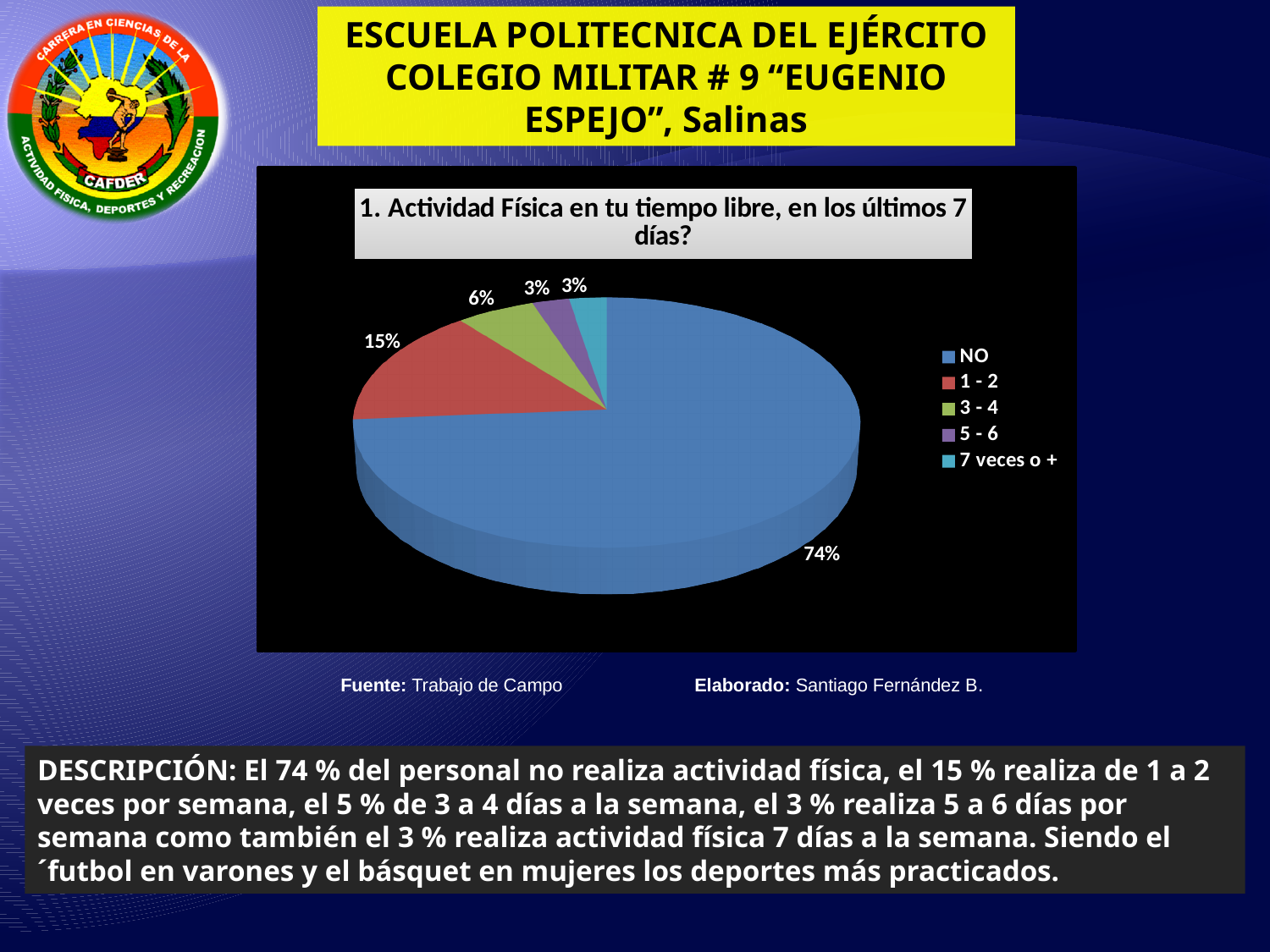
What colour is the slice for the category "NO"? blue Which category has the largest slice of the pie? NO Which is larger, the slice for "1 - 2" or the slice for "3 - 4"? 1 - 2 What percentage of the pie corresponds to the category "NO"? 74% What is the difference in percentage points between the "NO" slice and the "1 - 2" slice? 59 How many categories does the legend of the pie chart list? 5 What is the difference in percentage points between the "1 - 2" slice and the "3 - 4" slice? 9 What percentage of the pie corresponds to the category "3 - 4"? 6% What type of chart is shown on the slide? pie chart What percentage of the pie corresponds to the category "7 veces o +"? 3% What is the title of the chart? 1. Actividad Física en tu tiempo libre, en los últimos 7 días? What percentage of the pie corresponds to the category "1 - 2"? 15%